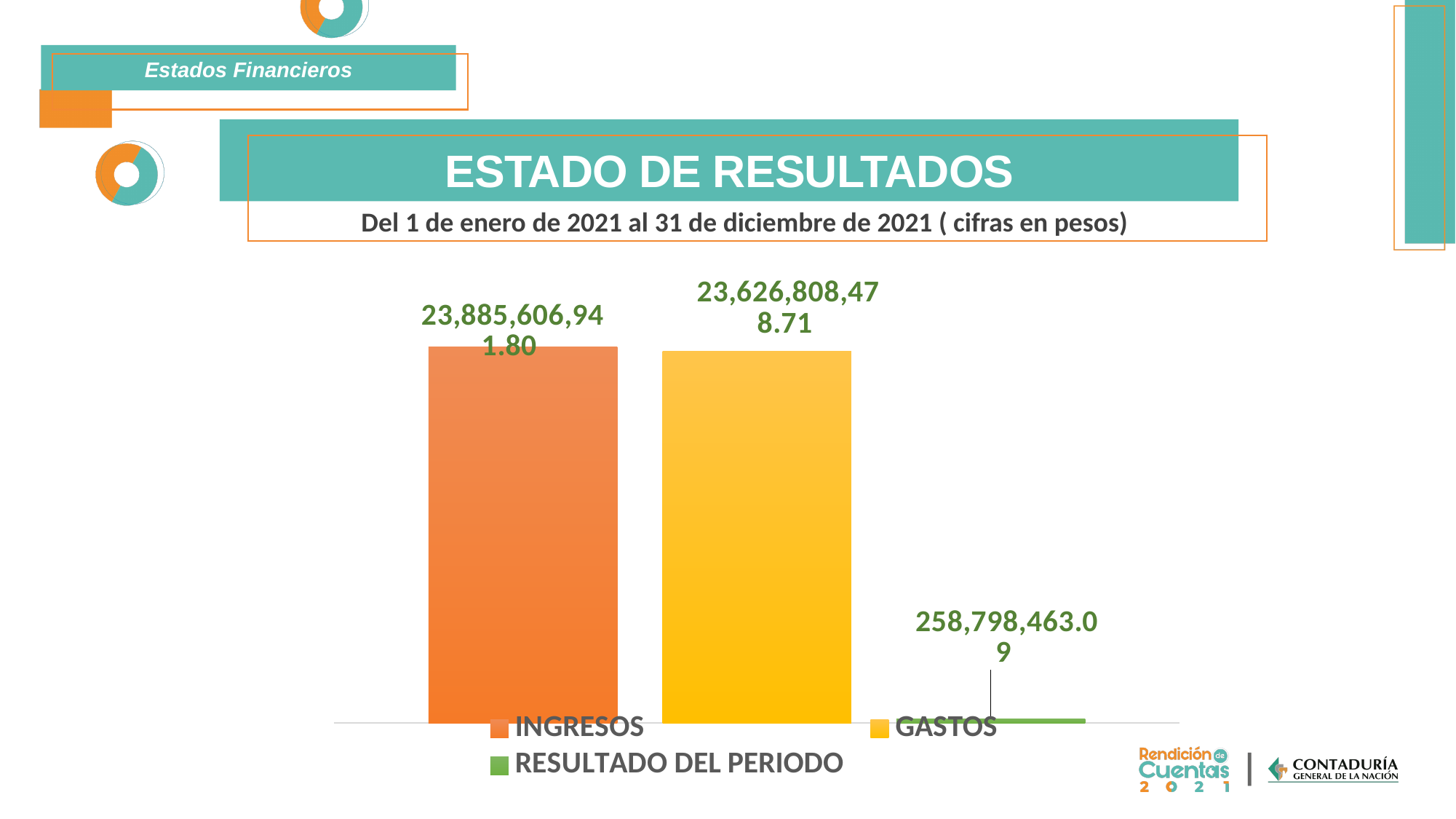
Which is larger, INGRESOS or GASTOS? INGRESOS Which series has the lowest value? RESULTADO DEL PERIODO Which series has the highest value? INGRESOS What is the value for INGRESOS? 23,885,606,941.80 How many series does the legend list? 3 What kind of chart is shown on the slide? Bar chart What is the difference between INGRESOS and GASTOS? 258,798,463.09 What is the value for RESULTADO DEL PERIODO? 258,798,463.09 What colour is the bar for GASTOS? Yellow What is the value for GASTOS? 23,626,808,478.71 Which is larger, GASTOS or RESULTADO DEL PERIODO? GASTOS What is the title of the chart? ESTADO DE RESULTADOS